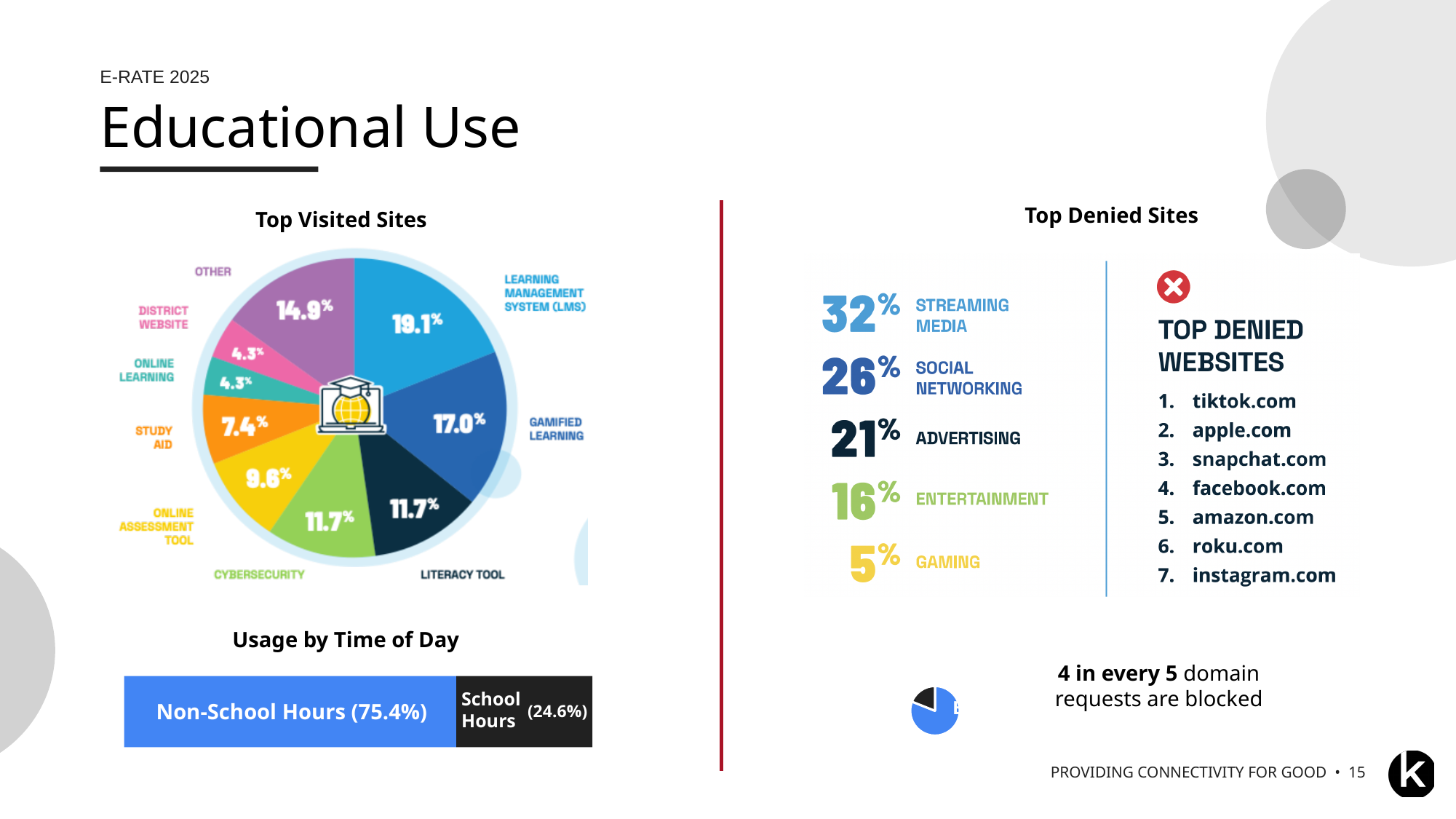
In the Top Denied Sites section, which category has the lowest percentage? Gaming In the Top Visited Sites pie chart, which category has the largest share? Learning Management System (LMS) In the Top Visited Sites pie chart, what is the difference between the Other slice and the Study Aid slice? 7.5% In the Top Visited Sites pie chart, what share is Learning Management System (LMS)? 19.1% In the Top Visited Sites pie chart, which is larger: Cybersecurity or Online Learning? Cybersecurity In the Top Denied Sites section, what percentage is Streaming Media? 32% In the Usage by Time of Day chart, what percentage is Non-School Hours? 75.4% How many categories are shown in the Top Visited Sites pie chart? 9 What kind of chart is Top Visited Sites? Pie chart In the Top Visited Sites pie chart, what share is Gamified Learning? 17.0% In the Usage by Time of Day chart, what percentage is School Hours? 24.6% In the Top Visited Sites pie chart, what share is Online Assessment Tool? 9.6%